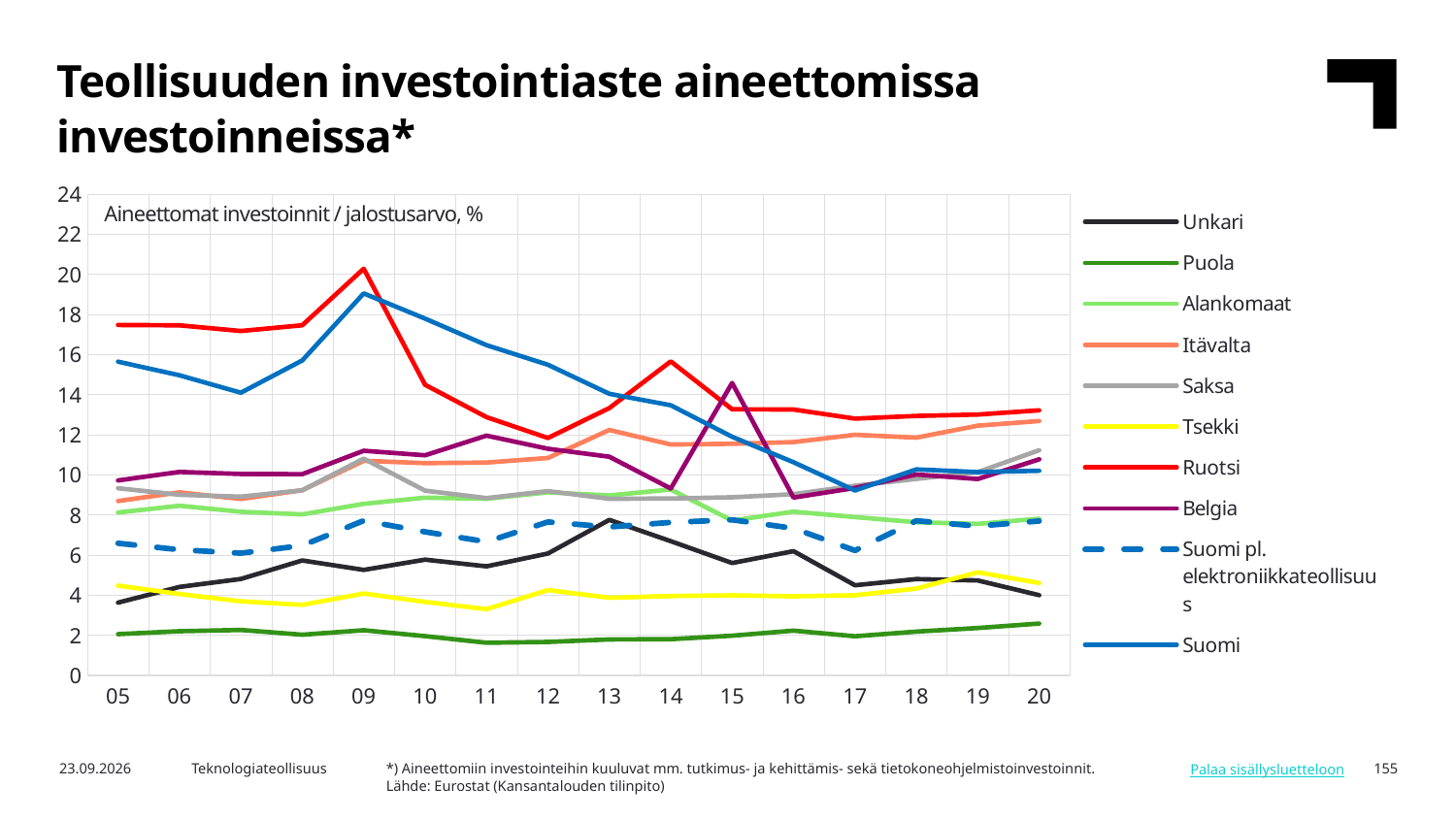
Which is larger in 15, the value for Belgia or the value for Saksa? Belgia Which series has the lowest value in 05? Puola How many years are plotted along the x axis? 16 What kind of chart is shown on the slide? line chart Is the value for Tsekki in 11 greater or less than 4? less Does the value for Suomi rise or fall from 09 to 17? fall How many series does the legend list? 10 Which series has the highest value in 05? Ruotsi Is the value for Suomi in 09 greater or less than 18? greater Is the value for Ruotsi in 05 greater or less than 16? greater Which series is drawn with a dashed line? Suomi pl. elektroniikkateollisuus